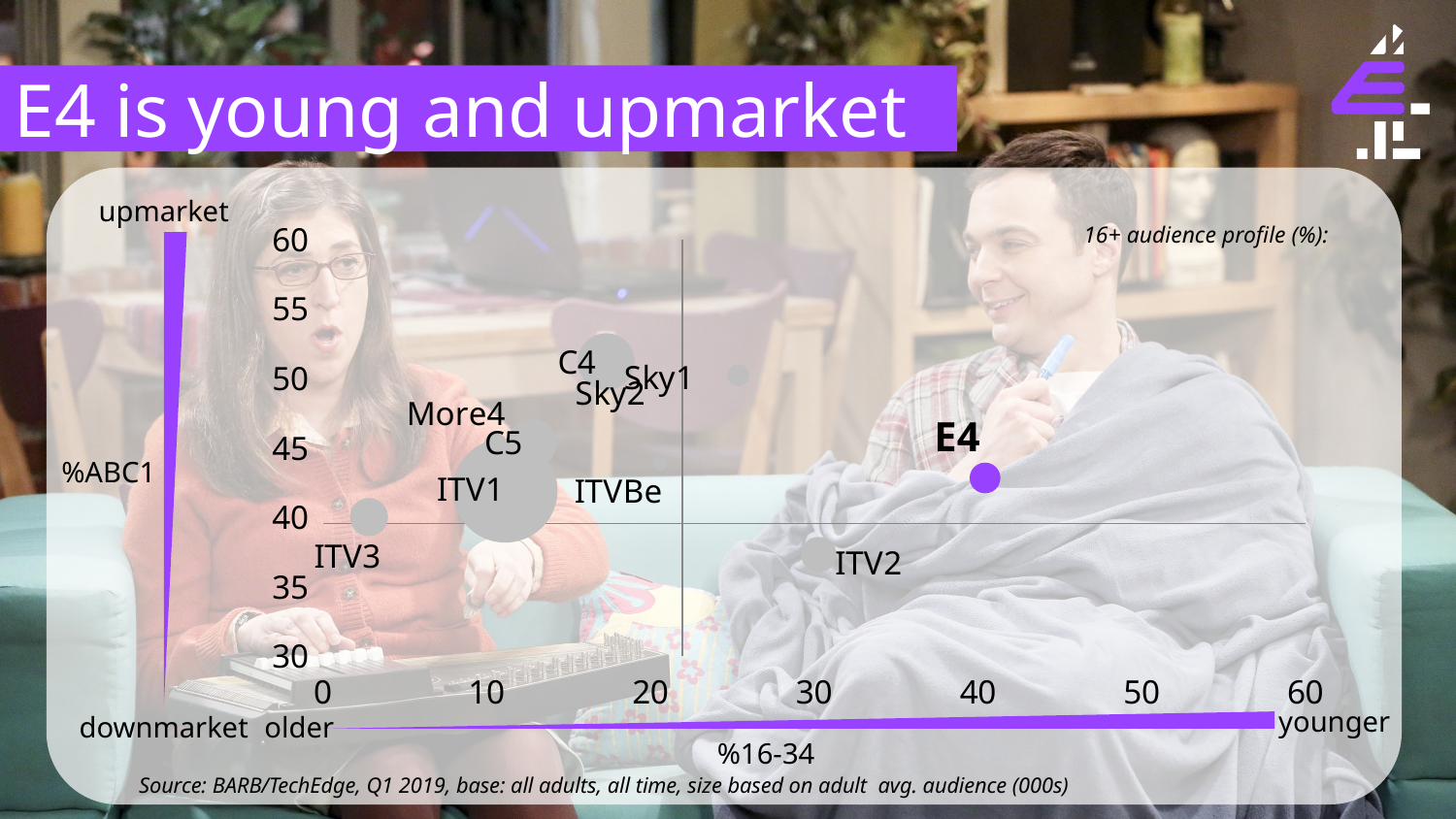
How many channels are plotted on the chart? 10 Is the %ABC1 value for ITV2 greater or less than 40? less Which channel has a higher %16-34 value, E4 or ITV1? E4 Is the %16-34 value for ITV3 greater or less than 10? less What is the title of the slide's chart? E4 is young and upmarket Which channel has the lowest %ABC1 value? ITV2 Which channel has the highest %16-34 value? E4 Is the %ABC1 value for E4 greater or less than 40? greater What does the horizontal axis of the chart measure? %16-34 What kind of chart is shown on the slide? Bubble (scatter) chart Which channel has the lowest %16-34 value? ITV3